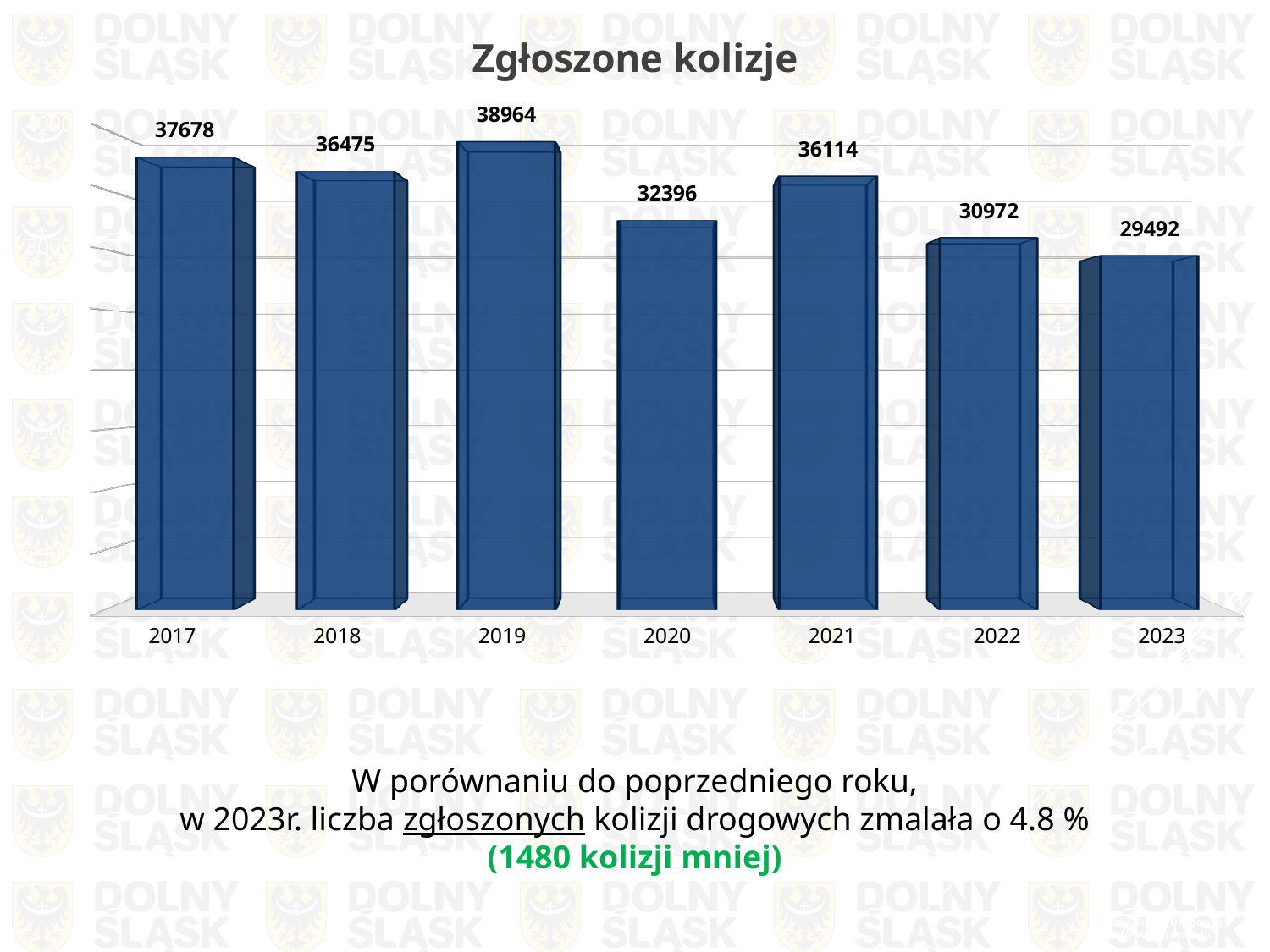
Which is larger, the value for 2018 or the value for 2021? 2018 What is the value for 2019 in the chart? 38964 What kind of chart is shown on the slide? bar chart Which is larger, the value for 2020 or the value for 2022? 2020 What is the value for 2023 in the chart? 29492 Which year has the highest value in the chart? 2019 What is the value for 2020 in the chart? 32396 What is the difference between the values for 2022 and 2023? 1480 What is the difference between the values for 2019 and 2020? 6568 Which year has the lowest value in the chart? 2023 What is the title of the chart? Zgłoszone kolizje How many years are shown in the chart? 7